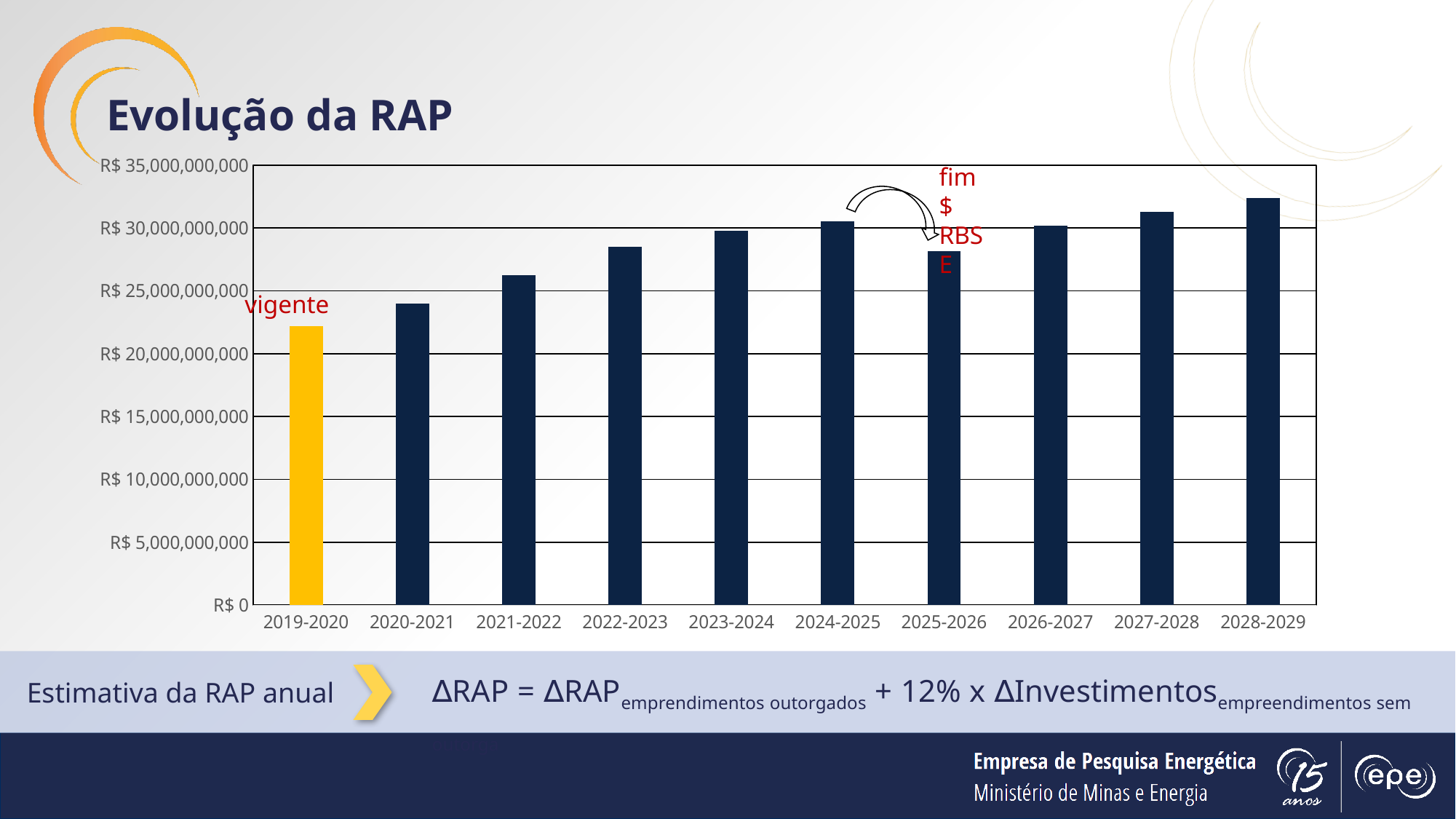
Which is larger, the value for 2024-2025 or the value for 2025-2026? 2024-2025 How many periods (bars) are shown on the x axis of the chart? 10 Do the values rise or fall from 2019-2020 to 2024-2025? rise Is the value for 2019-2020 greater or less than R$ 20,000,000,000? greater Is the value for 2020-2021 greater or less than R$ 25,000,000,000? less Which period has the lowest RAP value in the chart? 2019-2020 What kind of chart is shown on the slide? bar chart What is the title of the chart? Evolução da RAP Which period's bar is shown in a different colour (yellow) from the others? 2019-2020 Which period has the highest RAP value in the chart? 2028-2029 Is the value for 2028-2029 greater or less than R$ 35,000,000,000? less